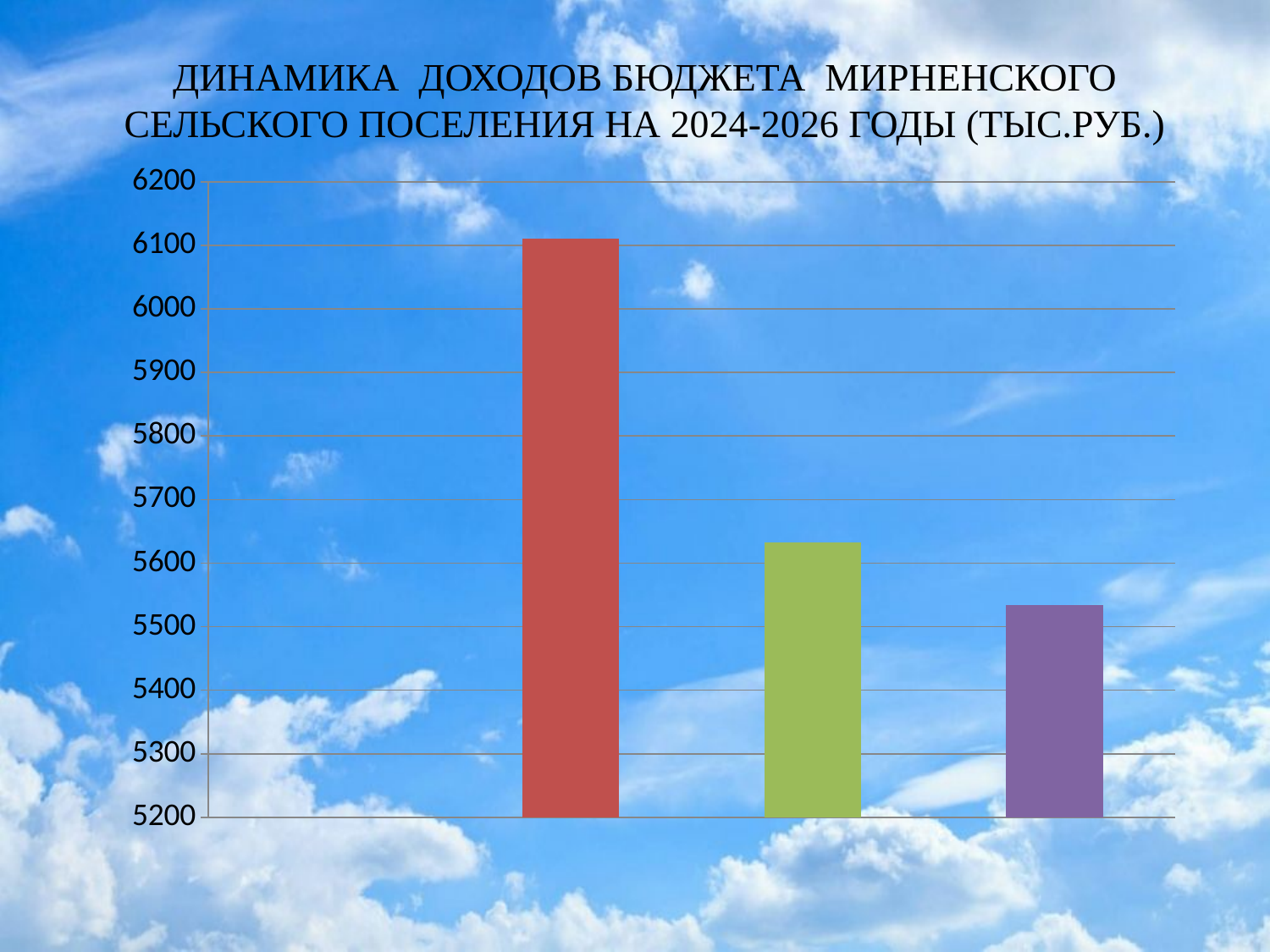
How many bars are plotted in the chart? 3 What kind of chart is shown on the slide? bar chart Is the value of the purple (third) bar greater or less than 5500? greater Do the bar values rise or fall from left to right across the chart? fall What is the highest value shown on the vertical axis of the chart? 6200 What unit of measurement is given in the chart title? ТЫС.РУБ. Is the value of the purple (third) bar greater or less than 5600? less Is the value of the green (second) bar greater or less than 5700? less Which bar is the shortest in the chart: the red, the green or the purple one? the purple bar Which is larger, the value of the green bar or the value of the purple bar? the green bar Which bar is the tallest in the chart: the red, the green or the purple one? the red bar